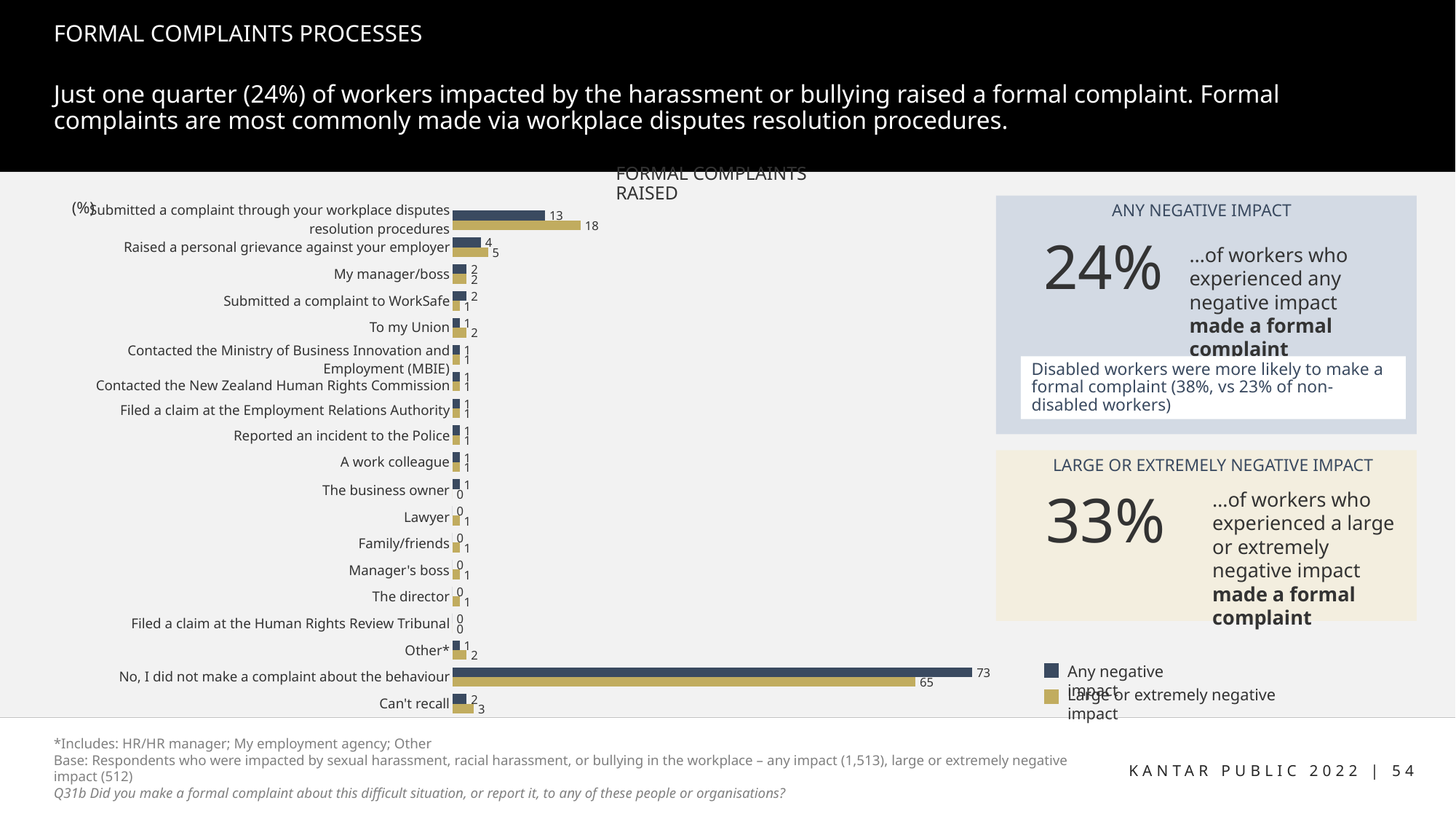
What is the value for 'Raised a personal grievance against your employer' in the 'Large or extremely negative impact' series? 5 Which category has the highest value in the 'Any negative impact' series? No, I did not make a complaint about the behaviour What is the value for 'Submitted a complaint through your workplace disputes resolution procedures' in the 'Large or extremely negative impact' series? 18 What is the value for 'Can't recall' in the 'Large or extremely negative impact' series? 3 What is the value for 'Submitted a complaint through your workplace disputes resolution procedures' in the 'Any negative impact' series? 13 What is the difference between the 'Any negative impact' and 'Large or extremely negative impact' values for 'No, I did not make a complaint about the behaviour'? 8 What is the title of the chart? FORMAL COMPLAINTS RAISED What type of chart is shown on the slide? bar chart How many categories are plotted in the chart? 19 How many series does the chart legend list? 2 For 'Submitted a complaint through your workplace disputes resolution procedures', which series has the larger value: 'Any negative impact' or 'Large or extremely negative impact'? Large or extremely negative impact What is the value for 'No, I did not make a complaint about the behaviour' in the 'Any negative impact' series? 73